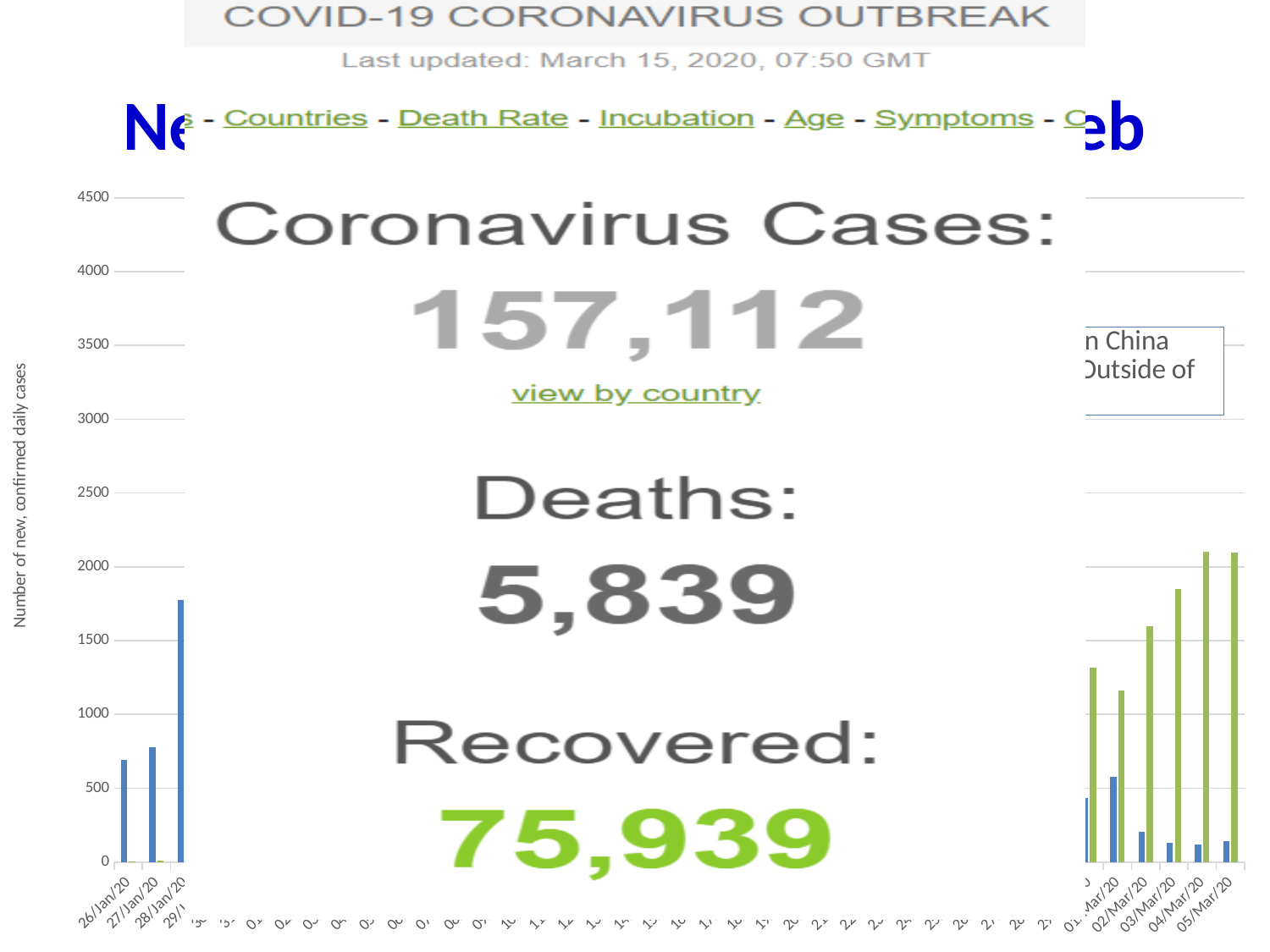
Is the blue bar for 26/Jan/20 greater or less than 500? greater Do the blue bars rise or fall from 26/Jan/20 to 28/Jan/20? rise Which is larger, the blue bar for 26/Jan/20 or the blue bar for 28/Jan/20? 28/Jan/20 Is the blue bar for 27/Jan/20 greater or less than 1000? less Is the blue bar for 28/Jan/20 greater or less than 1500? greater On 05/Mar/20, which bar is larger, the blue one or the green one? the green one What is the title of the vertical axis of the chart? Number of new, confirmed daily cases What is the highest value shown on the vertical axis of the chart? 4500 Do the green bars rise or fall across the March dates shown at the right of the chart? rise What kind of chart is shown on the slide? bar chart